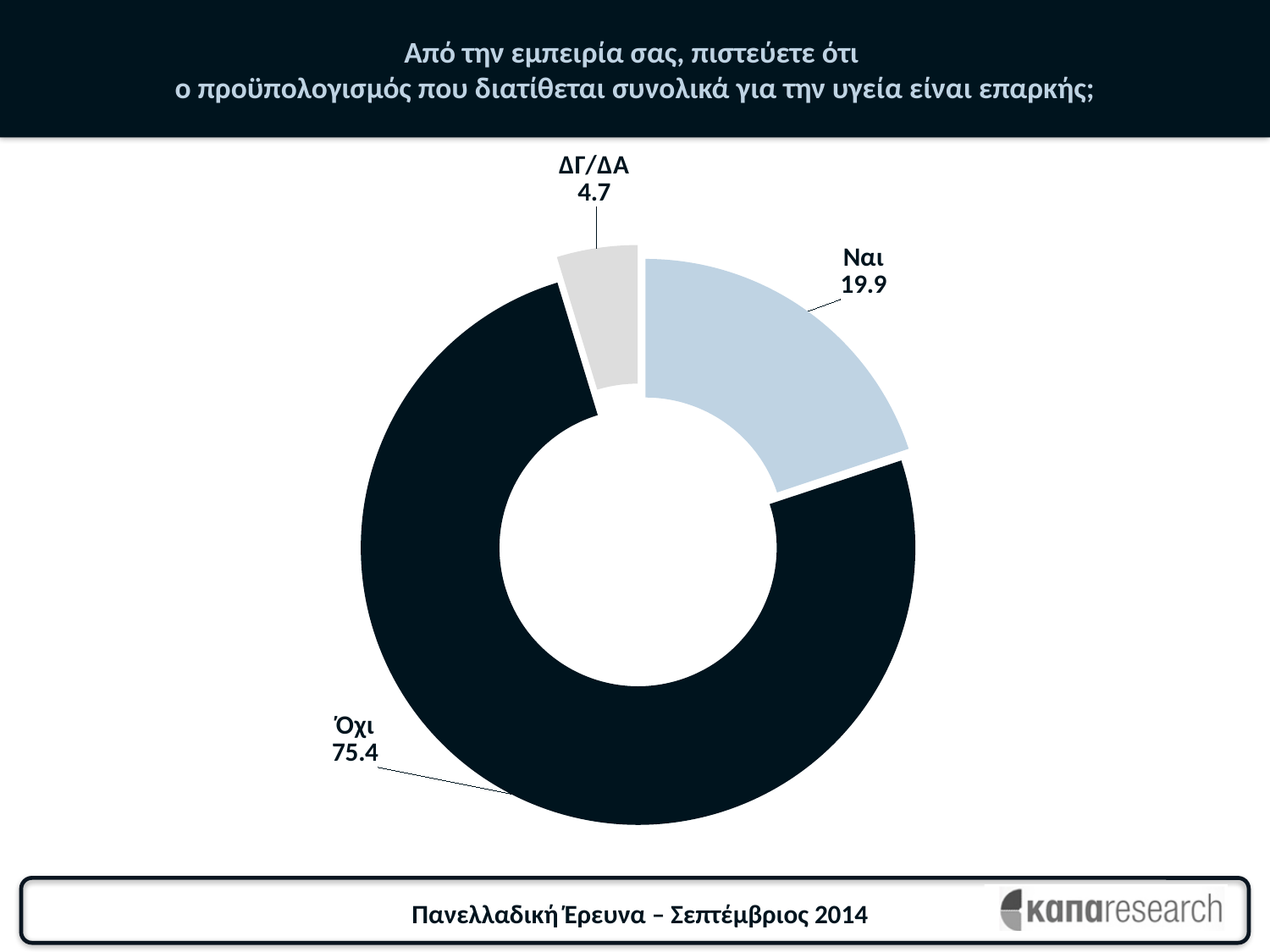
What colour is the slice for Όχι? Black What value is shown for Ναι? 19.9 How many categories are shown in the chart? 3 What is the difference between the values for Ναι and ΔΓ/ΔΑ? 15.2 What value is shown for ΔΓ/ΔΑ? 4.7 Which is larger, the value for Ναι or the value for ΔΓ/ΔΑ? Ναι Which category has the smallest slice? ΔΓ/ΔΑ What value is shown for Όχι? 75.4 Which category has the largest slice? Όχι What is the difference between the values for Όχι and Ναι? 55.5 What kind of chart is shown on the slide? Doughnut (pie) chart What colour is the slice for Ναι? Light blue